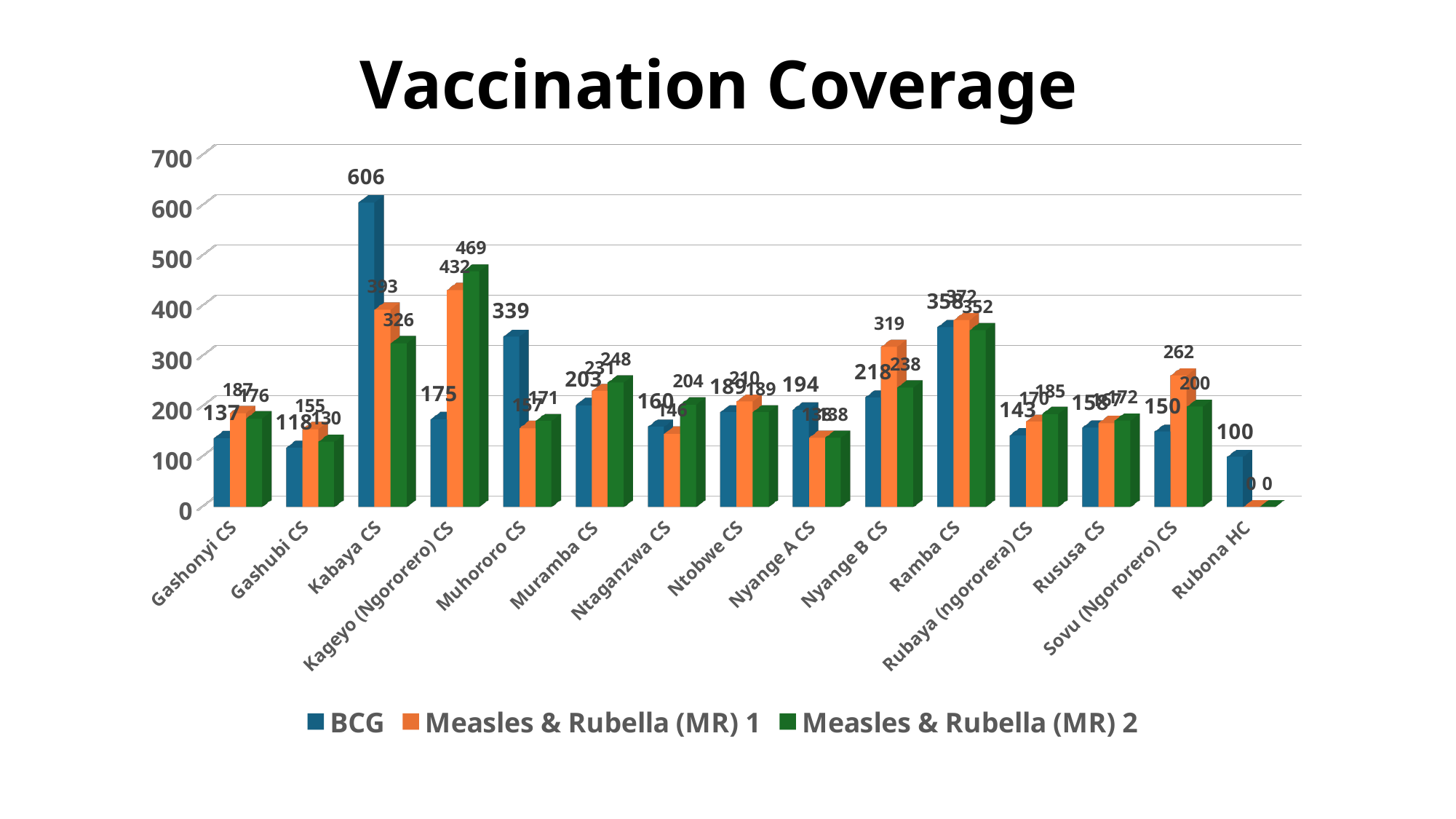
How many series does the legend list? 3 What is the difference between the BCG value and the Measles & Rubella (MR) 1 value for Kabaya CS? 213 What is the Measles & Rubella (MR) 2 value for Kageyo (Ngororero) CS? 469 For Nyange B CS, which is larger: the BCG value or the Measles & Rubella (MR) 1 value? Measles & Rubella (MR) 1 What is the BCG value for Kabaya CS? 606 What kind of chart is shown on the slide? Bar chart Which health centre has the highest BCG value? Kabaya CS What is the Measles & Rubella (MR) 1 value for Sovu (Ngororero) CS? 262 How many health centres are shown on the x axis? 15 Is the BCG value for Kageyo (Ngororero) CS greater or less than 200? less Which health centre has the lowest BCG value? Rubona HC What is the BCG value for Muhororo CS? 339